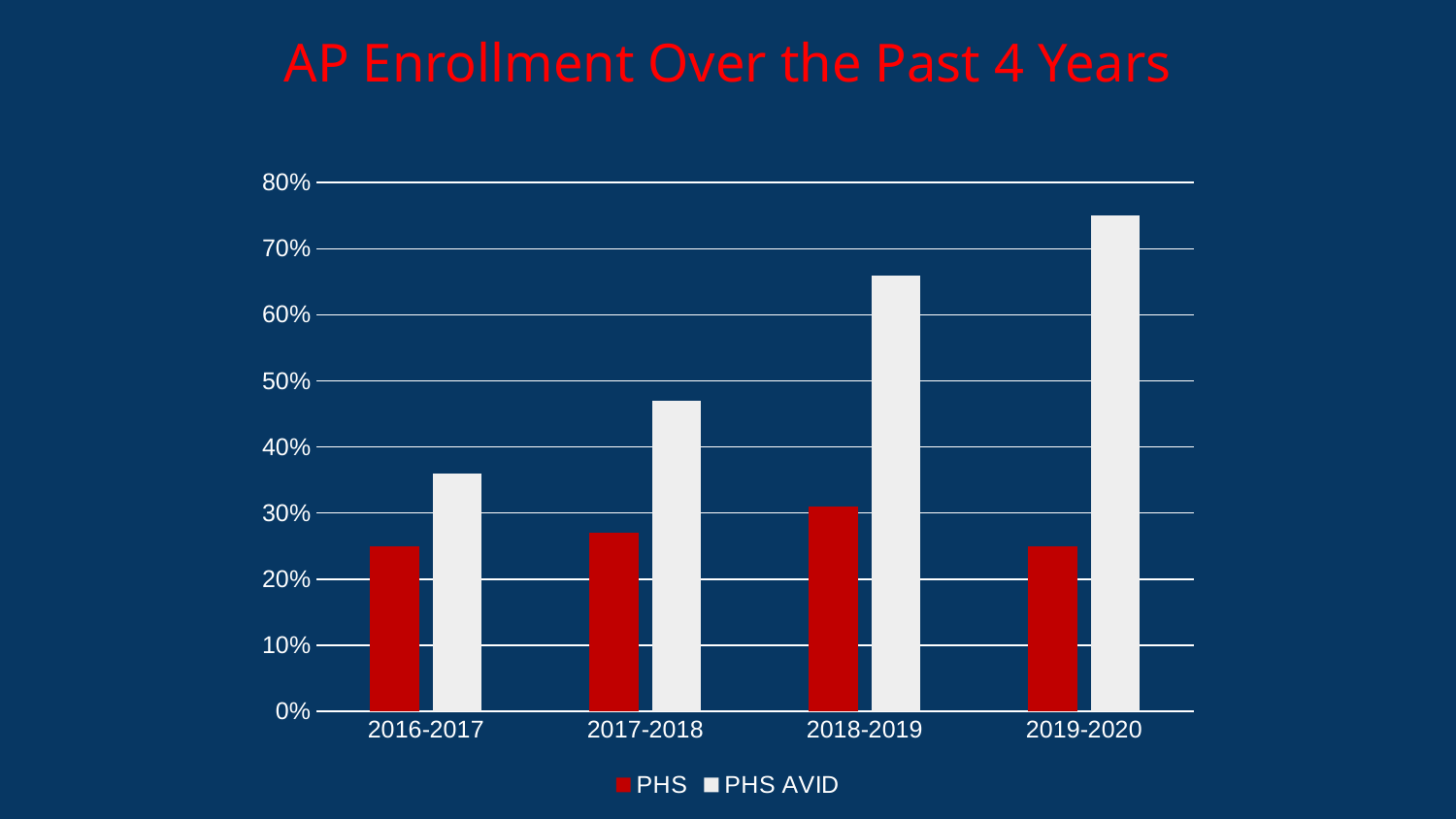
Is the PHS value for 2017-2018 greater or less than 30%? less Do the PHS AVID values rise or fall from 2016-2017 to 2019-2020? rise Which school year has the highest PHS AVID value? 2019-2020 How many school years are shown on the x axis? 4 Which school year has the lowest PHS AVID value? 2016-2017 In 2018-2019, which is larger, the PHS value or the PHS AVID value? PHS AVID How many series does the legend list? 2 What is the title of the chart? AP Enrollment Over the Past 4 Years Which school year has the highest PHS value? 2018-2019 Is the PHS AVID value for 2019-2020 greater or less than 70%? greater Is the PHS AVID value for 2016-2017 greater or less than 40%? less What kind of chart is shown on the slide? bar chart